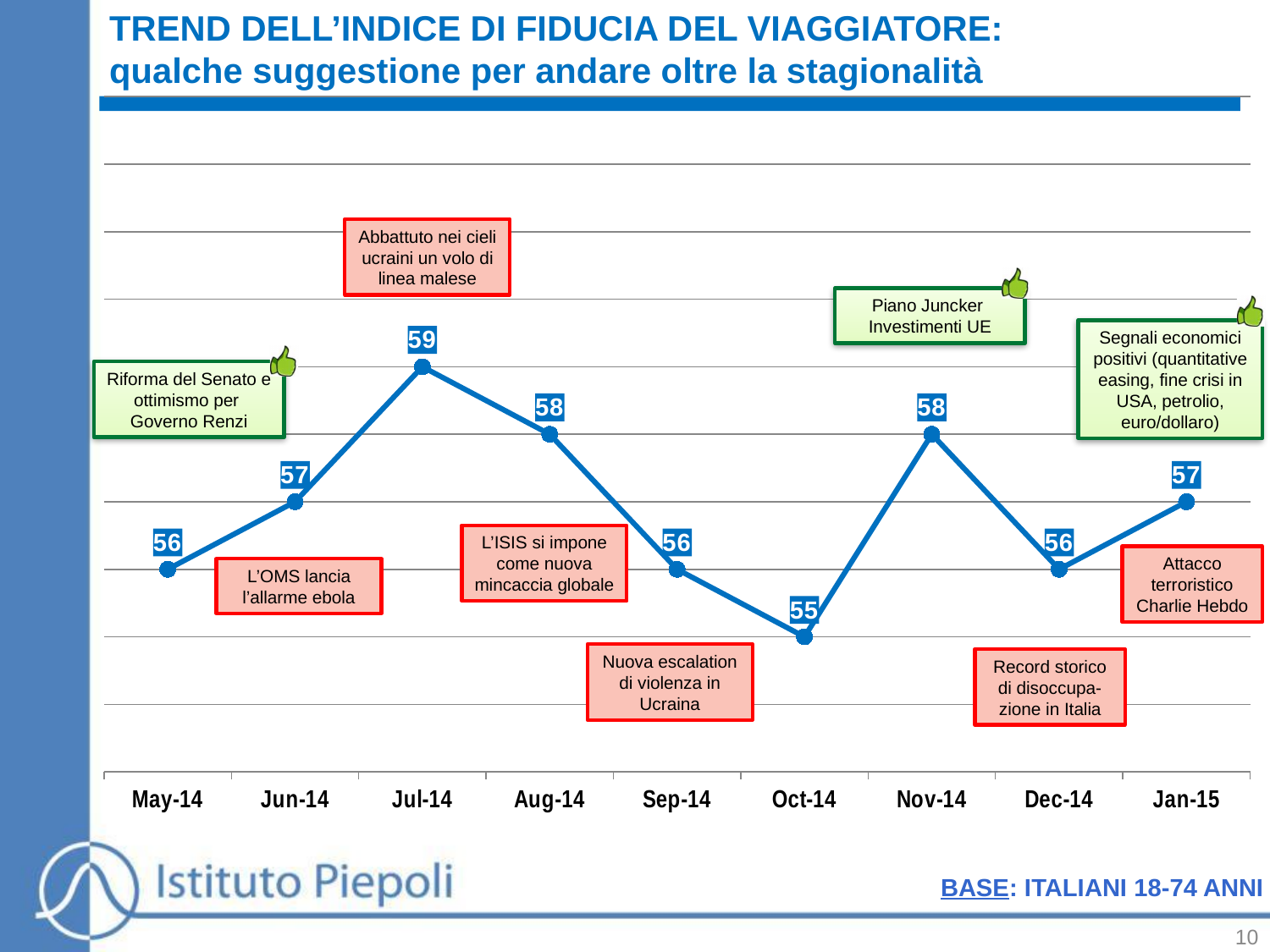
What is the value for Oct-14? 55 What is the value for Jan-15? 57 Which month has the highest value? Jul-14 What is the value for Nov-14? 58 What is the difference between the values for Jul-14 and Oct-14? 4 What kind of chart is shown on the slide? Line chart What is the value for Jul-14? 59 Does the value rise or fall from Sep-14 to Oct-14? Fall Which month has the lowest value? Oct-14 Which is larger, the value for Aug-14 or the value for Sep-14? Aug-14 How many months are plotted on the x axis? 9 What is the difference between the values for Nov-14 and Dec-14? 2